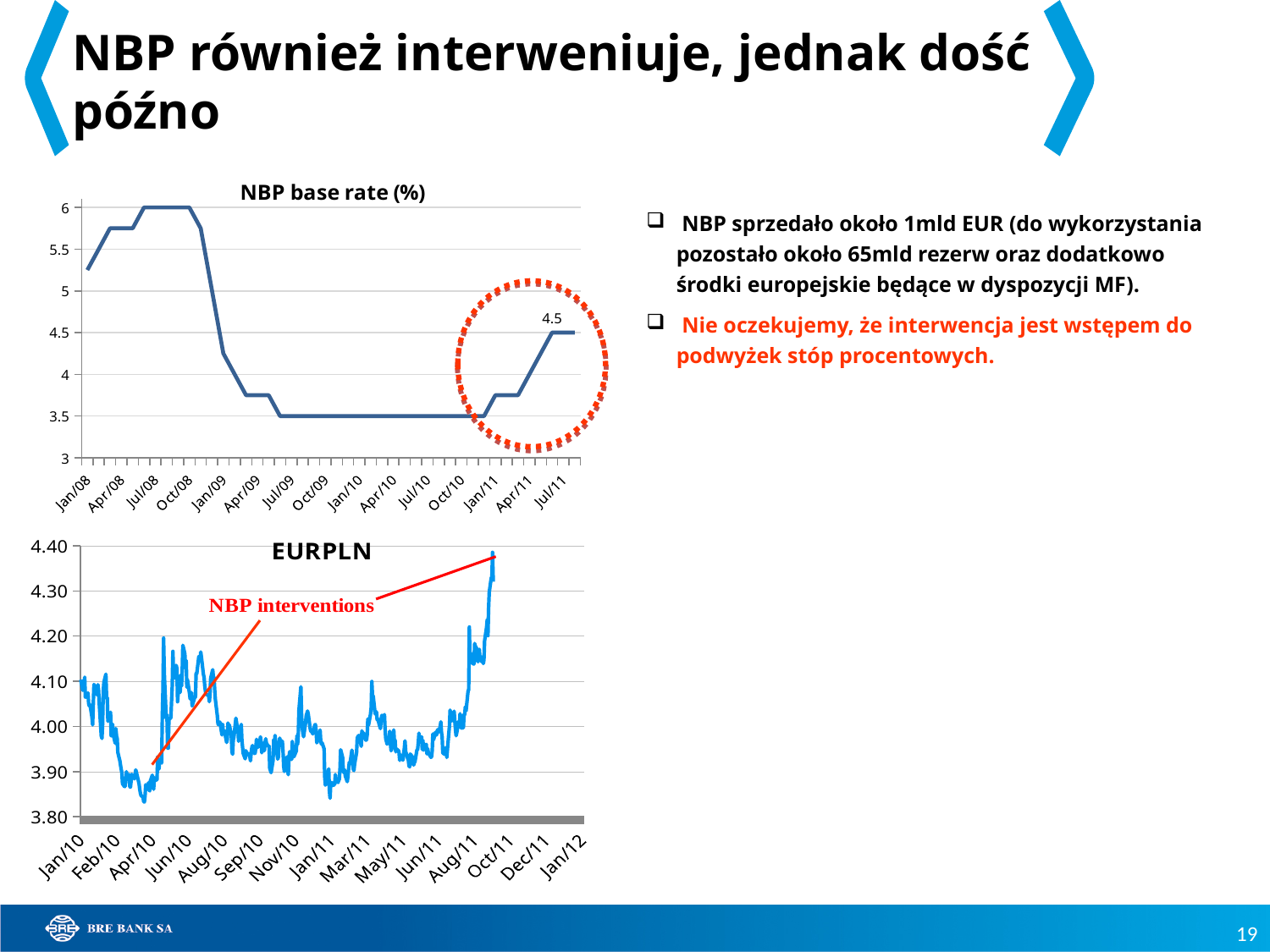
On the NBP base rate (%) chart, is the base rate in Jan/08 greater or less than 5? greater On the NBP base rate (%) chart, does the base rate rise or fall between Jan/09 and Jul/09? fall On the NBP base rate (%) chart, what is the highest value the base rate reaches? 6 On the EURPLN chart, is the value at Jan/10 greater or less than 4.00? greater What kind of chart is the EURPLN chart? line chart On the NBP base rate (%) chart, what is the lowest value the base rate reaches? 3.5 On the EURPLN chart, what does the red annotation text say? NBP interventions On the EURPLN chart, is the value at Apr/10 greater or less than 4.00? less On the NBP base rate (%) chart, does the base rate rise or fall between Jan/11 and Jul/11? rise On the NBP base rate (%) chart, what value is printed as the data label at the end of the line in Jul/11? 4.5 On the NBP base rate (%) chart, what is the difference between the highest rate (6) and the lowest rate (3.5)? 2.5